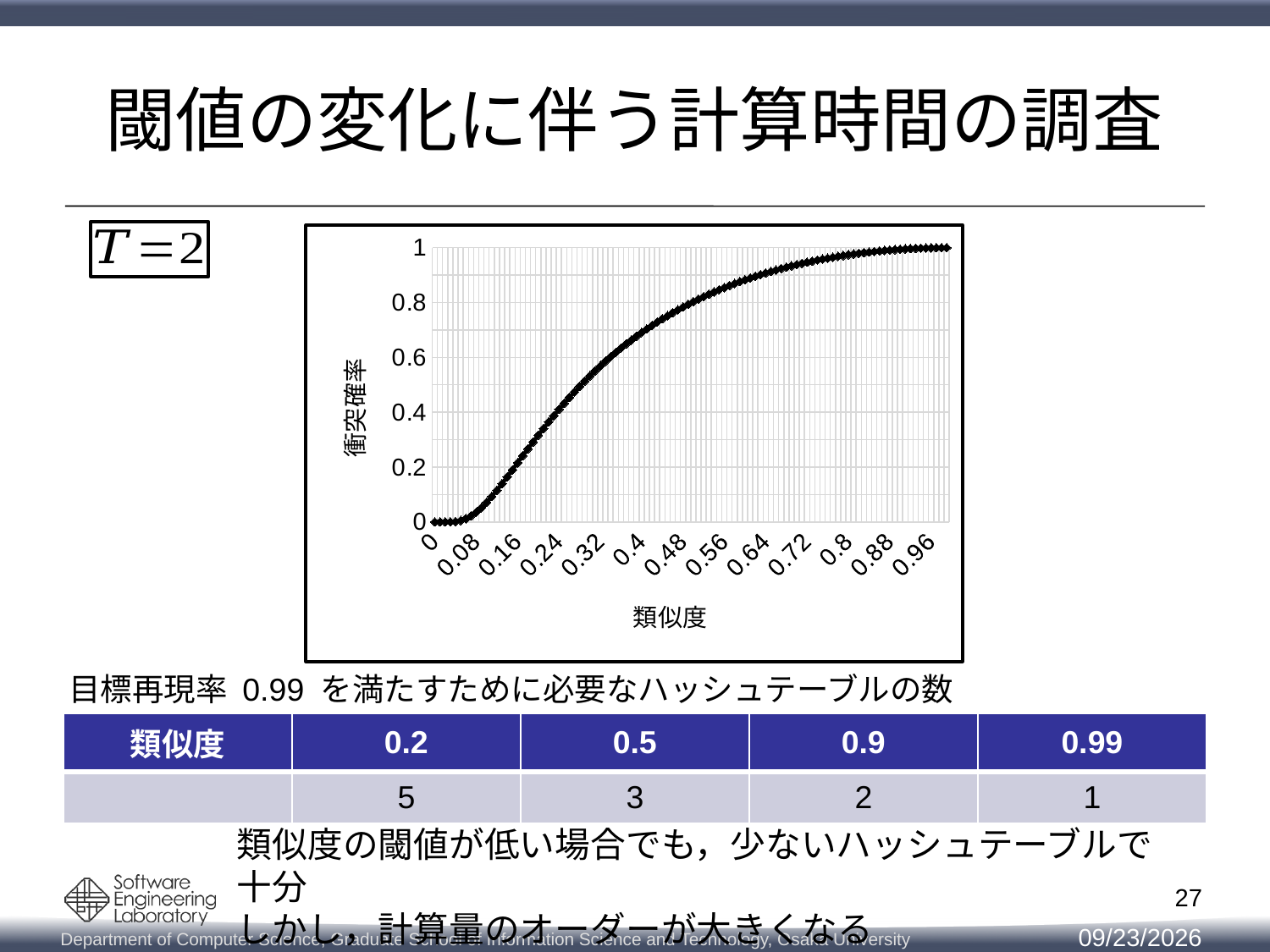
What is the highest value shown on the y axis of the chart? 1 Is the value of 衝突確率 at 類似度 0.8 greater or less than 0.8? greater Is the value of 衝突確率 at 類似度 0.56 greater or less than 0.6? greater Do the values in the chart rise or fall as 類似度 increases along the x axis? rise What is the title of the y axis of the chart? 衝突確率 Which has the larger 衝突確率 in the chart, 類似度 0.32 or 類似度 0.72? 0.72 What is the title of the x axis of the chart? 類似度 Is the value of 衝突確率 at 類似度 0.08 greater or less than 0.2? less